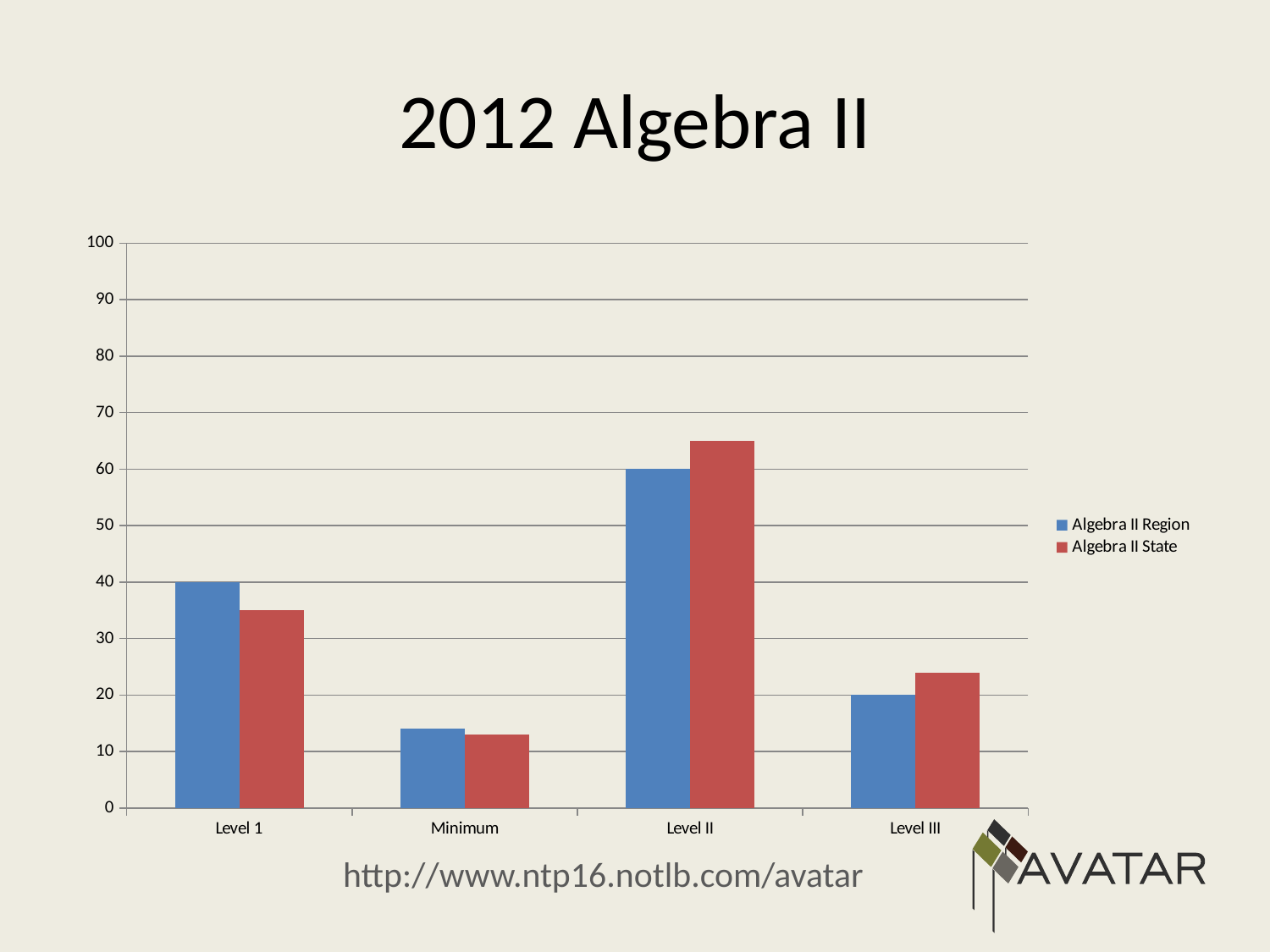
For Level 1, which is larger: Algebra II Region or Algebra II State? Algebra II Region What is the title of the chart? 2012 Algebra II How many series does the legend list? 2 What is the difference between the Algebra II Region values for Level II and Level III? 40 Which category has the lowest Algebra II Region value? Minimum What is the Algebra II Region value for Level II? 60 What type of chart is shown on the slide? Bar chart What is the Algebra II Region value for Level 1? 40 Is the Algebra II State value for Level II greater or less than 60? greater How many categories are shown on the x axis? 4 What is the Algebra II Region value for Level III? 20 Which category has the highest Algebra II State value? Level II